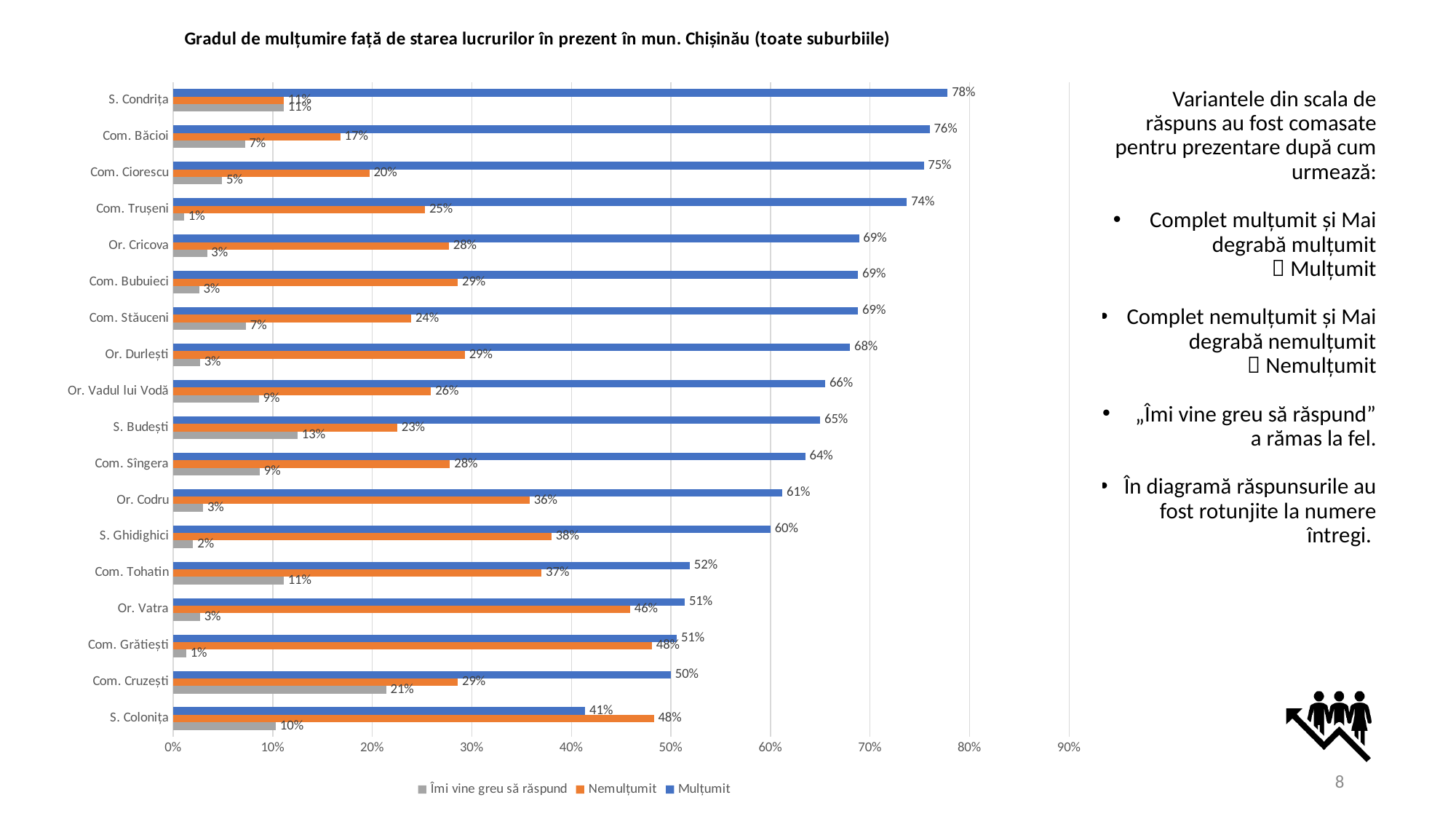
How many series does the legend list? 3 Which locality has the highest Nemulțumit value? S. Colonița and Com. Grătiești (both 48%) What is the 'Îmi vine greu să răspund' value for Com. Cruzești? 21% What is the Nemulțumit value for Or. Vatra? 46% How many localities (categories) are shown on the chart? 18 Which locality has the highest Mulțumit value? S. Condrița What kind of chart is shown on the slide? bar chart Which is larger for S. Colonița: the Mulțumit value or the Nemulțumit value? Nemulțumit What is the title of the chart? Gradul de mulțumire față de starea lucrurilor în prezent în mun. Chișinău (toate suburbiile) What is the Mulțumit value for Com. Trușeni? 74% What is the difference between the Mulțumit values of S. Condrița and S. Colonița? 37% Which locality has the lowest Mulțumit value? S. Colonița